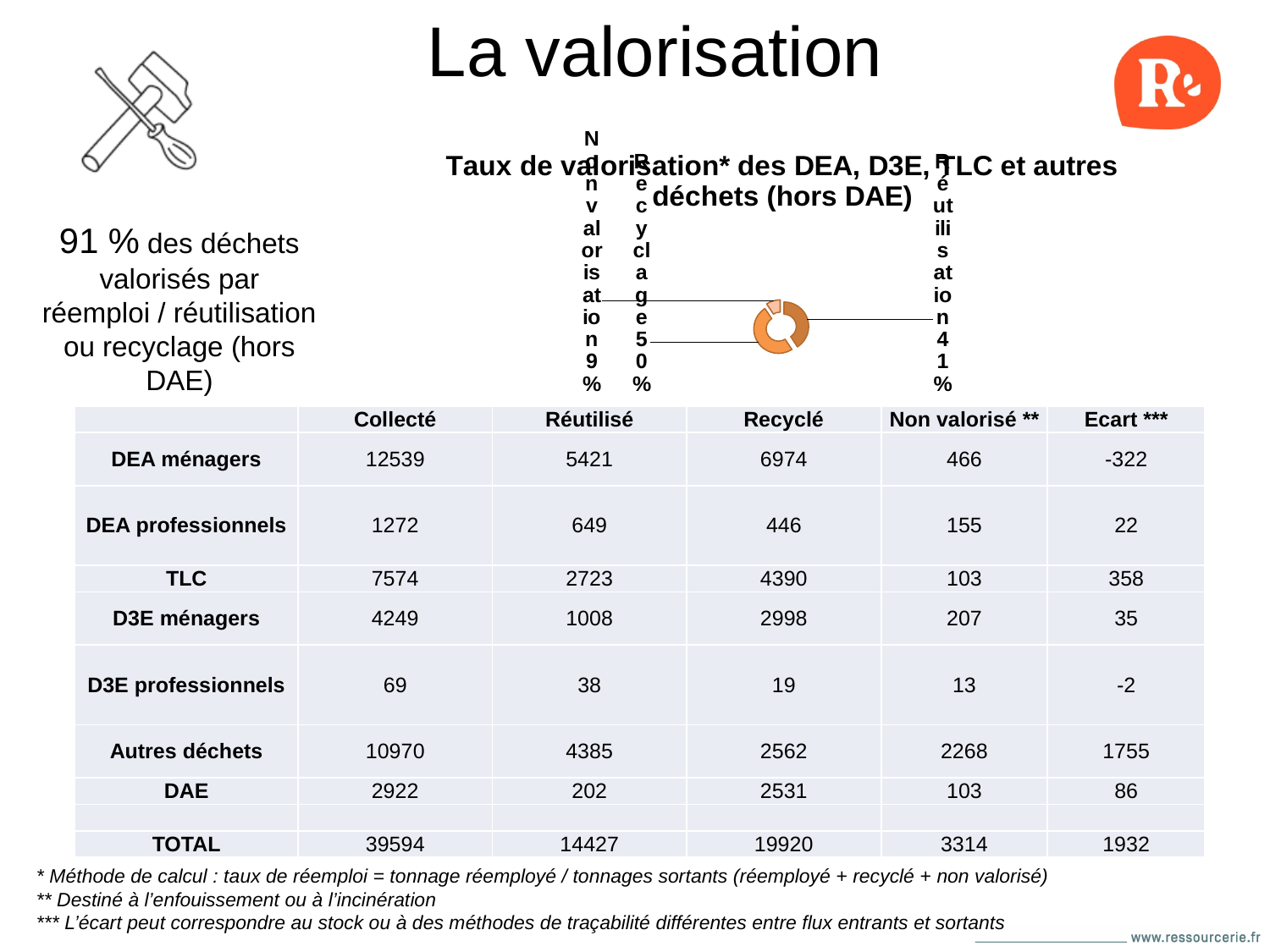
In the doughnut chart, is the share for Réutilisation greater or less than 50%? less In the doughnut chart, by how many percentage points does Recyclage exceed Réutilisation? 9 percentage points How many slices does the doughnut chart have? 3 Which slice of the doughnut chart has the largest share? Recyclage What is the title of the doughnut chart on the slide? Taux de valorisation* des DEA, D3E, TLC et autres déchets (hors DAE) What kind of chart is shown under the title "Taux de valorisation* des DEA, D3E, TLC et autres déchets (hors DAE)"? doughnut (pie) chart In the doughnut chart, what is the combined share of Recyclage and Réutilisation? 91% In the doughnut chart, which is larger: Réutilisation or Non valorisation? Réutilisation In the doughnut chart, what percentage is shown for Réutilisation? 41% In the doughnut chart, what percentage is shown for Non valorisation? 9% Which slice of the doughnut chart has the smallest share? Non valorisation In the doughnut chart, what percentage is shown for Recyclage? 50%